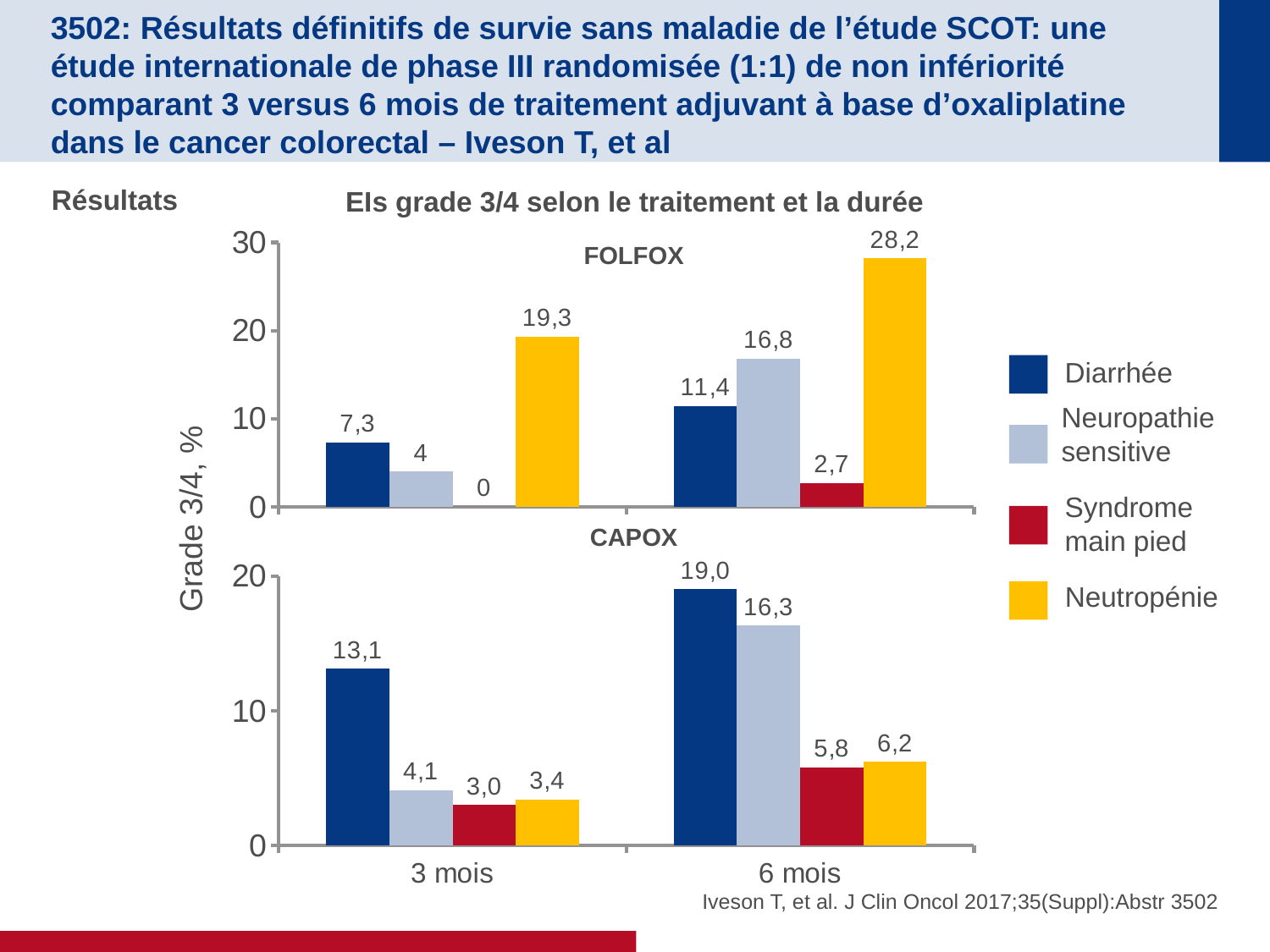
In the FOLFOX chart, which adverse event has the lowest value at 6 mois? Syndrome main pied In the CAPOX chart, what is the difference between Diarrhée at 6 mois and Diarrhée at 3 mois? 5,9 In the FOLFOX chart, what is the value for Neutropénie at 6 mois? 28,2 In the FOLFOX chart, is the value for Neutropénie at 3 mois greater or less than 10? greater How many series does the legend list? 4 In the CAPOX chart, which adverse event has the highest value at 6 mois? Diarrhée In the FOLFOX chart, what is the value for Syndrome main pied at 3 mois? 0 What kind of chart is used for the FOLFOX and CAPOX data? Bar chart In the CAPOX chart, which is larger: Neuropathie sensitive at 6 mois or Neutropénie at 6 mois? Neuropathie sensitive What is the title of the chart? EIs grade 3/4 selon le traitement et la durée In the FOLFOX chart, what is the difference between Neutropénie at 6 mois and Neutropénie at 3 mois? 8,9 In the CAPOX chart, what is the value for Diarrhée at 3 mois? 13,1